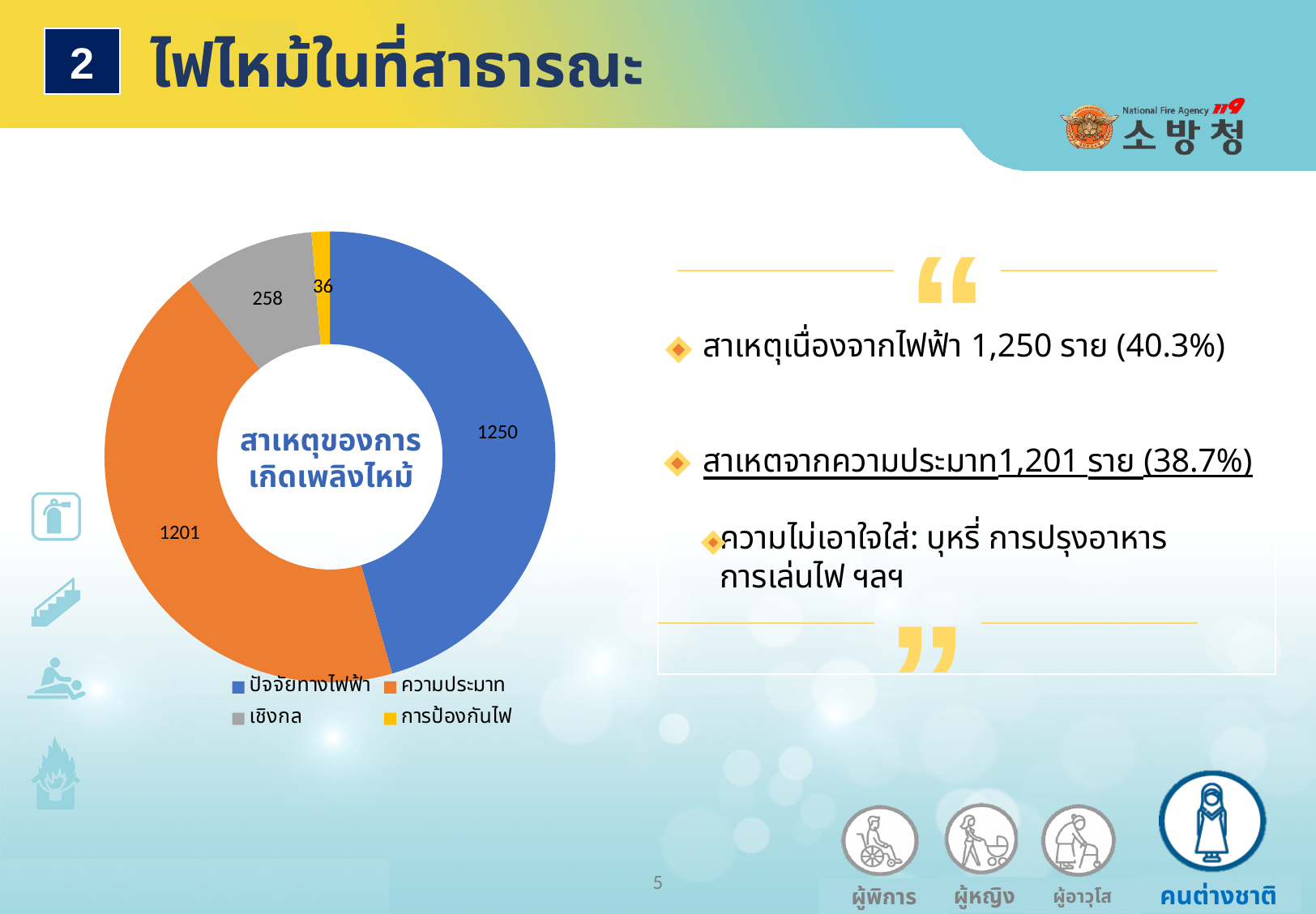
How many categories are shown in the chart? 4 Which category has the highest value in the chart? ปัจจัยทางไฟฟ้า What is the value for ปัจจัยทางไฟฟ้า in the chart? 1250 What is the value for เชิงกล in the chart? 258 What is the difference between the values for ปัจจัยทางไฟฟ้า and ความประมาท? 49 What is the difference between the values for เชิงกล and การป้องกันไฟ? 222 What is the value for การป้องกันไฟ in the chart? 36 Which category has the lowest value in the chart? การป้องกันไฟ What is the value for ความประมาท in the chart? 1201 Which is larger, the value for เชิงกล or the value for การป้องกันไฟ? เชิงกล What is the title shown in the centre of the chart? สาเหตุของการเกิดเพลิงไหม้ What kind of chart is shown on the slide? doughnut chart